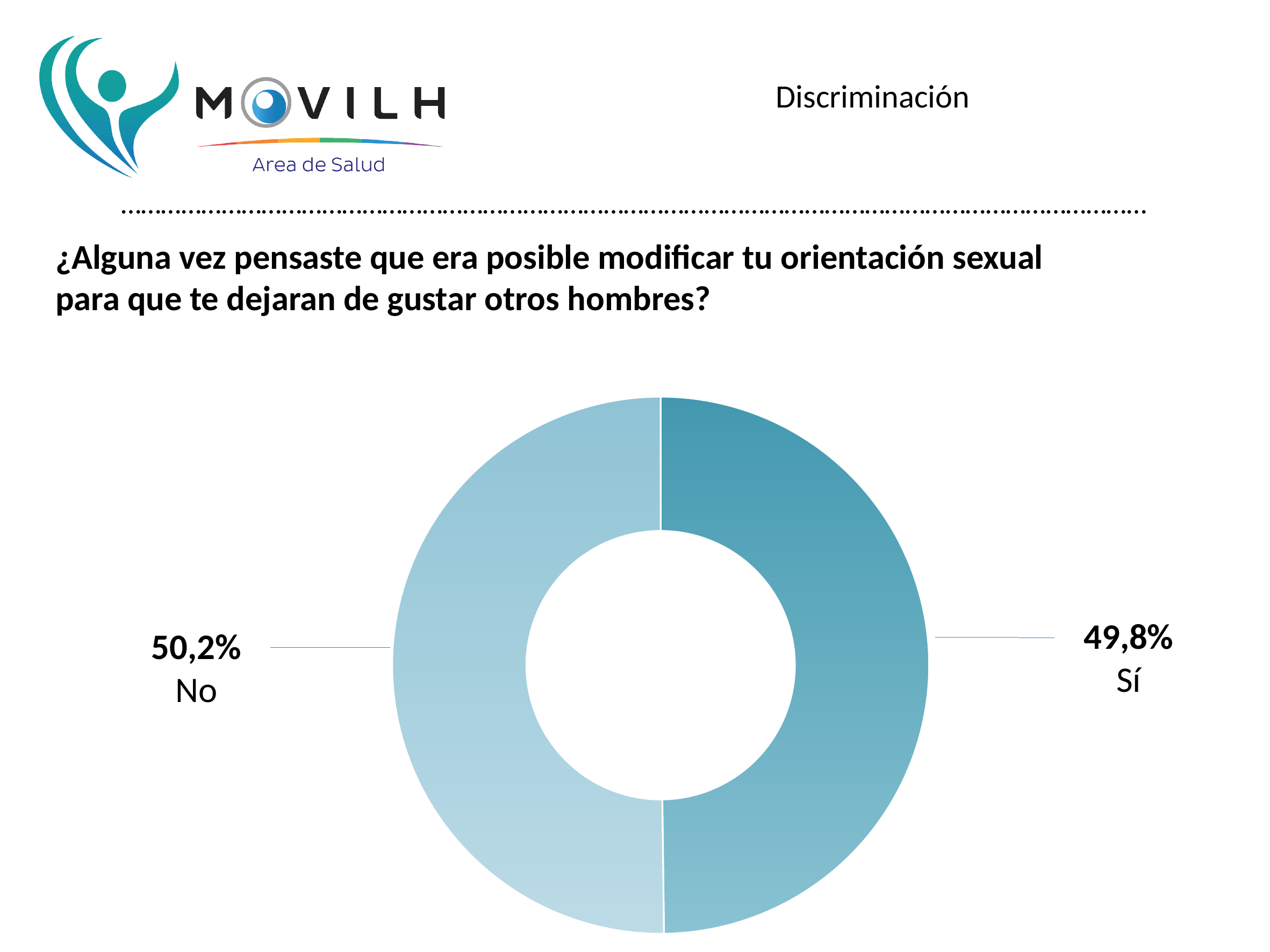
What is the difference in percentage points between the "No" and "Sí" responses? 0,4% What kind of chart is shown on the slide? Donut (pie) chart How many categories are shown in the chart? 2 Which response has the smallest share of the chart? Sí What share of the chart does the "Sí" slice represent? 49,8% Is the value for "No" greater or less than 50%? greater What percentage of respondents answered "Sí"? 49,8% What percentage of respondents answered "No"? 50,2% Which slice is drawn in the darker shade of blue, "No" or "Sí"? Sí Which response has the largest share of the chart? No Which response has the larger share of the chart, "No" or "Sí"? No Is the value for "Sí" greater or less than 50%? less